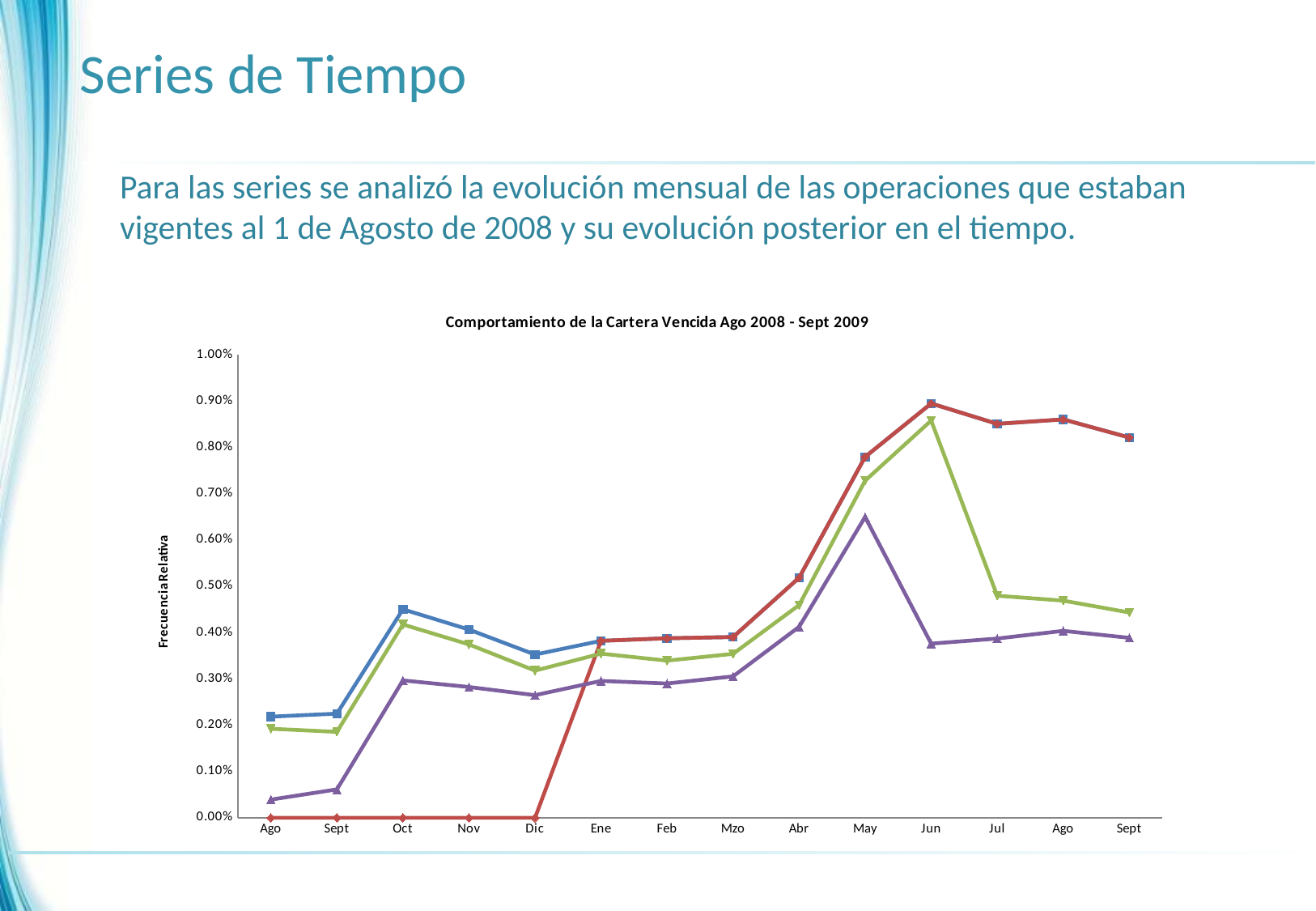
In which month does the red line reach its highest value? Jun How many months are shown along the x axis of the chart? 14 What is the value of the red line in Oct? 0.00% What kind of chart is shown on the slide? Line chart Does the red line rise or fall from Jun to Sept 2009? Fall In Jun, which line has the larger value, the red line or the purple line? The red line How many lines are plotted on the chart? 4 Is the value of the green line in Jul greater or less than 0.50%? less In which month does the purple line reach its highest value? May What is the title of the chart? Comportamiento de la Cartera Vencida Ago 2008 - Sept 2009 Is the value of the green line in Jun greater or less than 0.80%? greater What is the label on the vertical axis of the chart? Frecuencia Relativa